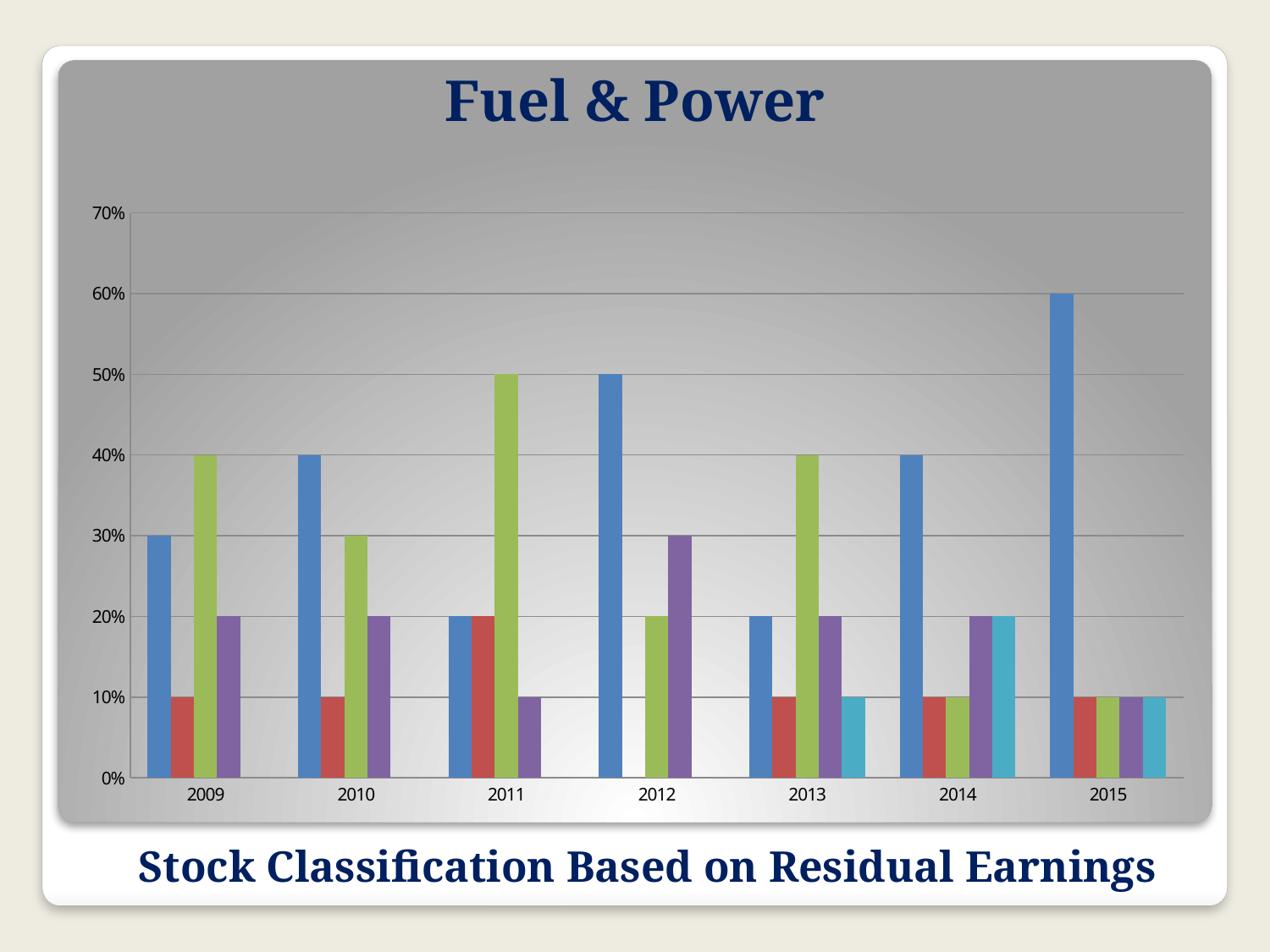
How many years are shown on the x axis of the chart? 7 What kind of chart is shown on the slide? bar chart Which is larger in 2009, the blue bar or the green bar? green bar What is the value of the purple bar for 2012? 30% In which year is the green bar highest? 2011 What is the value of the green bar for 2011? 50% What is the value of the blue bar for 2015? 60% In which year is the blue bar highest? 2015 What is the title of the chart? Fuel & Power What is the value of the blue bar for 2010? 40% What is the difference between the blue bar in 2015 and the blue bar in 2009? 30% Is the value of the blue bar for 2012 greater or less than 40%? greater